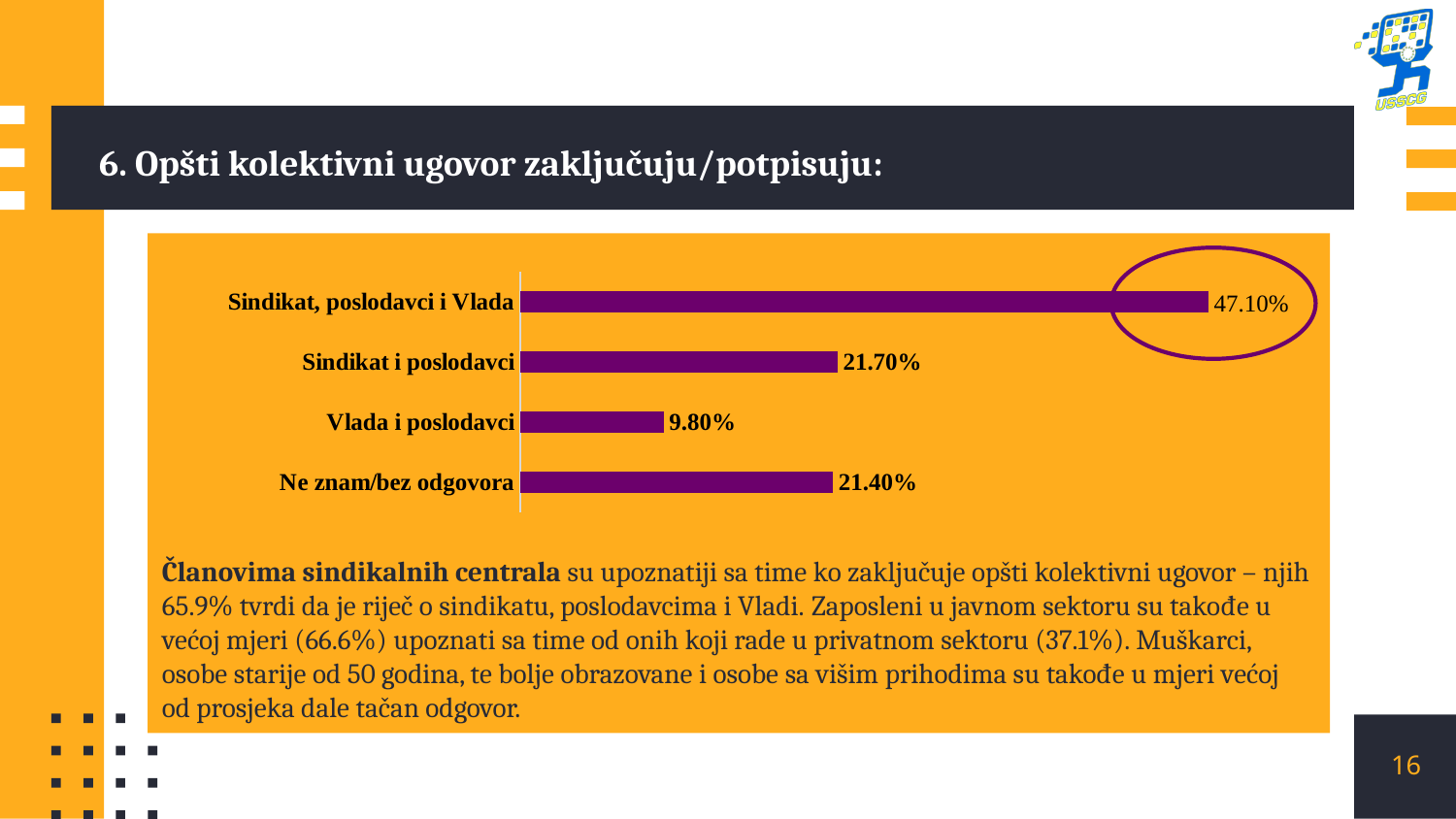
What is the value for "Sindikat i poslodavci"? 21.70% Which category has the lowest value? Vlada i poslodavci Which category has the highest value? Sindikat, poslodavci i Vlada Which category's bar is circled on the chart? Sindikat, poslodavci i Vlada What is the value for "Sindikat, poslodavci i Vlada"? 47.10% What is the difference between the values for "Sindikat, poslodavci i Vlada" and "Sindikat i poslodavci"? 25.40% What kind of chart is shown on the slide? Bar chart Which is larger: the value for "Sindikat i poslodavci" or the value for "Vlada i poslodavci"? Sindikat i poslodavci How many categories are shown in the chart? 4 What is the value for "Ne znam/bez odgovora"? 21.40% What is the value for "Vlada i poslodavci"? 9.80% What is the difference between the values for "Sindikat i poslodavci" and "Vlada i poslodavci"? 11.90%